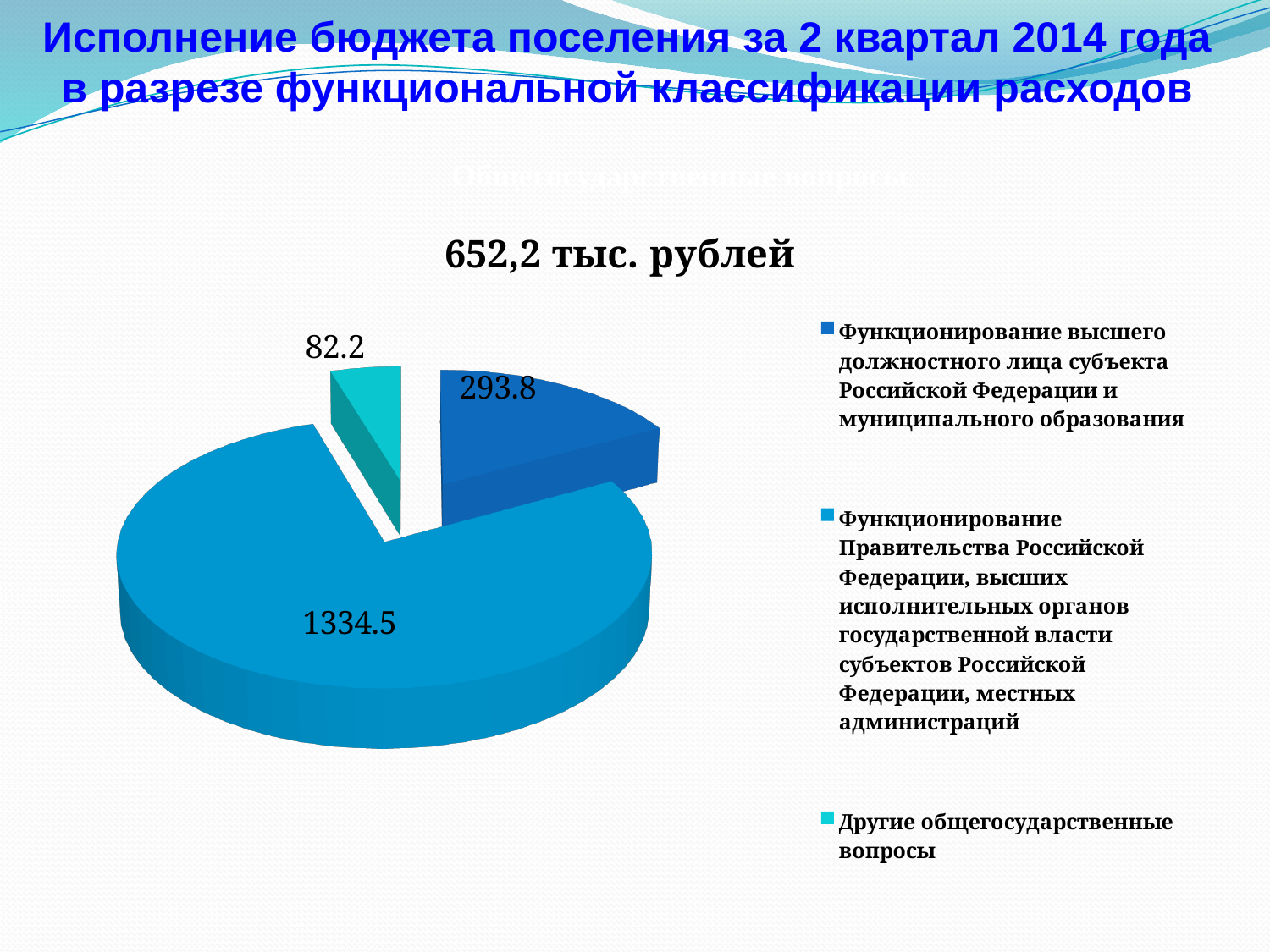
What kind of chart is shown on the slide? Pie chart What is the value for "Функционирование высшего должностного лица субъекта Российской Федерации и муниципального образования"? 293.8 What is the value for "Функционирование Правительства Российской Федерации, высших исполнительных органов государственной власти субъектов Российской Федерации, местных администраций"? 1334.5 How many entries does the legend list? 3 How many slices does the pie chart have? 3 Which is larger: the slice for "Функционирование высшего должностного лица..." or the slice for "Другие общегосударственные вопросы"? Функционирование высшего должностного лица... What is the difference between the largest slice (1334.5) and the slice for "Функционирование высшего должностного лица..." (293.8)? 1040.7 What is the difference between the value for "Функционирование высшего должностного лица..." (293.8) and the value for "Другие общегосударственные вопросы" (82.2)? 211.6 Which category has the smallest slice of the pie? Другие общегосударственные вопросы What is the value for "Другие общегосударственные вопросы"? 82.2 What text is shown as the chart's title above the pie? 652,2 тыс. рублей Which category has the largest slice of the pie? Функционирование Правительства Российской Федерации, высших исполнительных органов государственной власти субъектов Российской Федерации, местных администраций